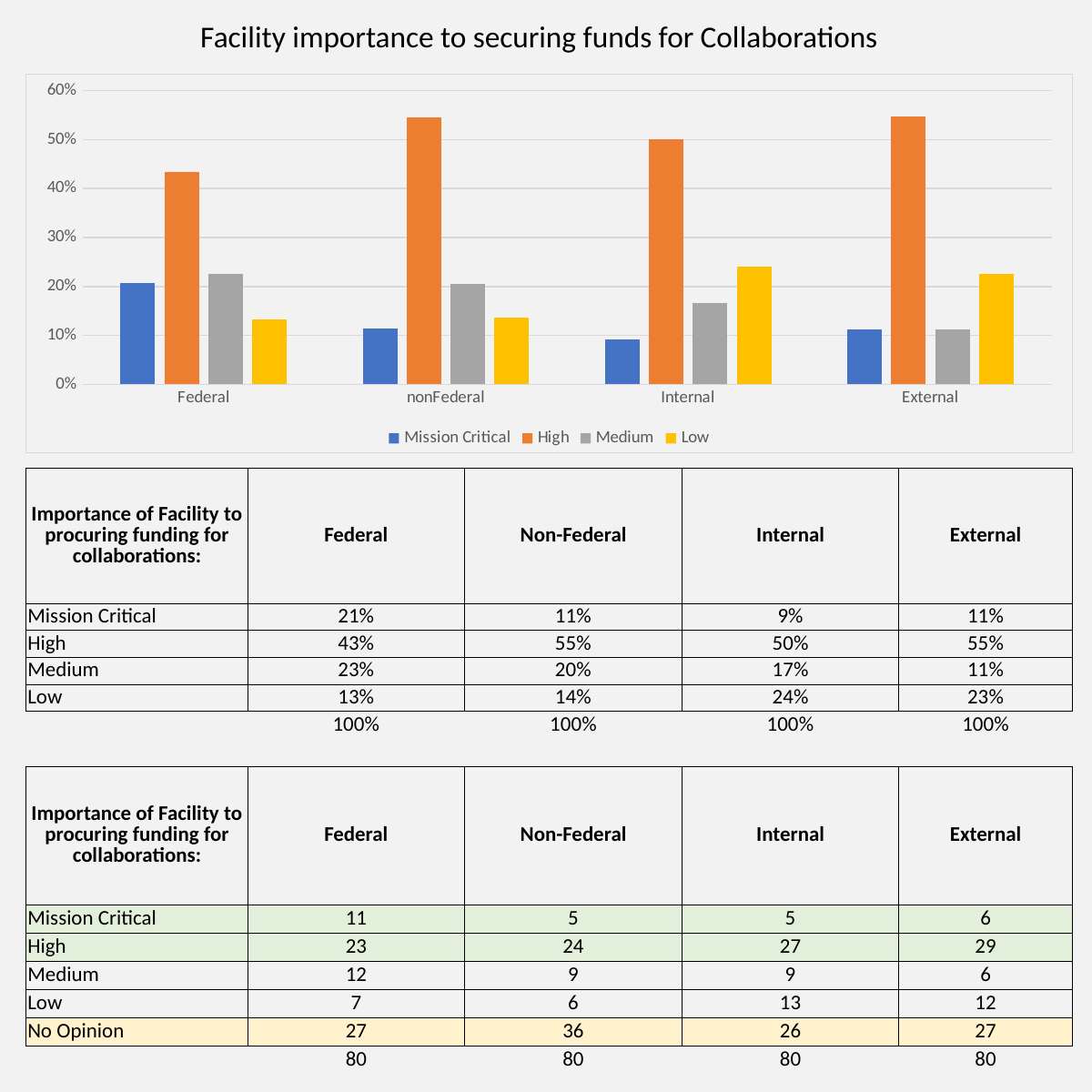
Is the Low value for Internal greater or less than 20%? greater According to the percentage table, what is the High value for Internal? 50% For Internal, which is larger: the Low bar or the Medium bar? Low Which category has the lowest Medium bar? External Which colour represents the High series in the chart legend? orange Is the High value for Federal greater or less than 40%? greater What kind of chart is shown on the slide? bar chart How many series does the chart legend list? 4 Is the Mission Critical value for Internal greater or less than 10%? less How many categories are shown along the x axis of the chart? 4 For Federal, which is larger: the Medium bar or the Low bar? Medium Which category has the highest Mission Critical bar? Federal